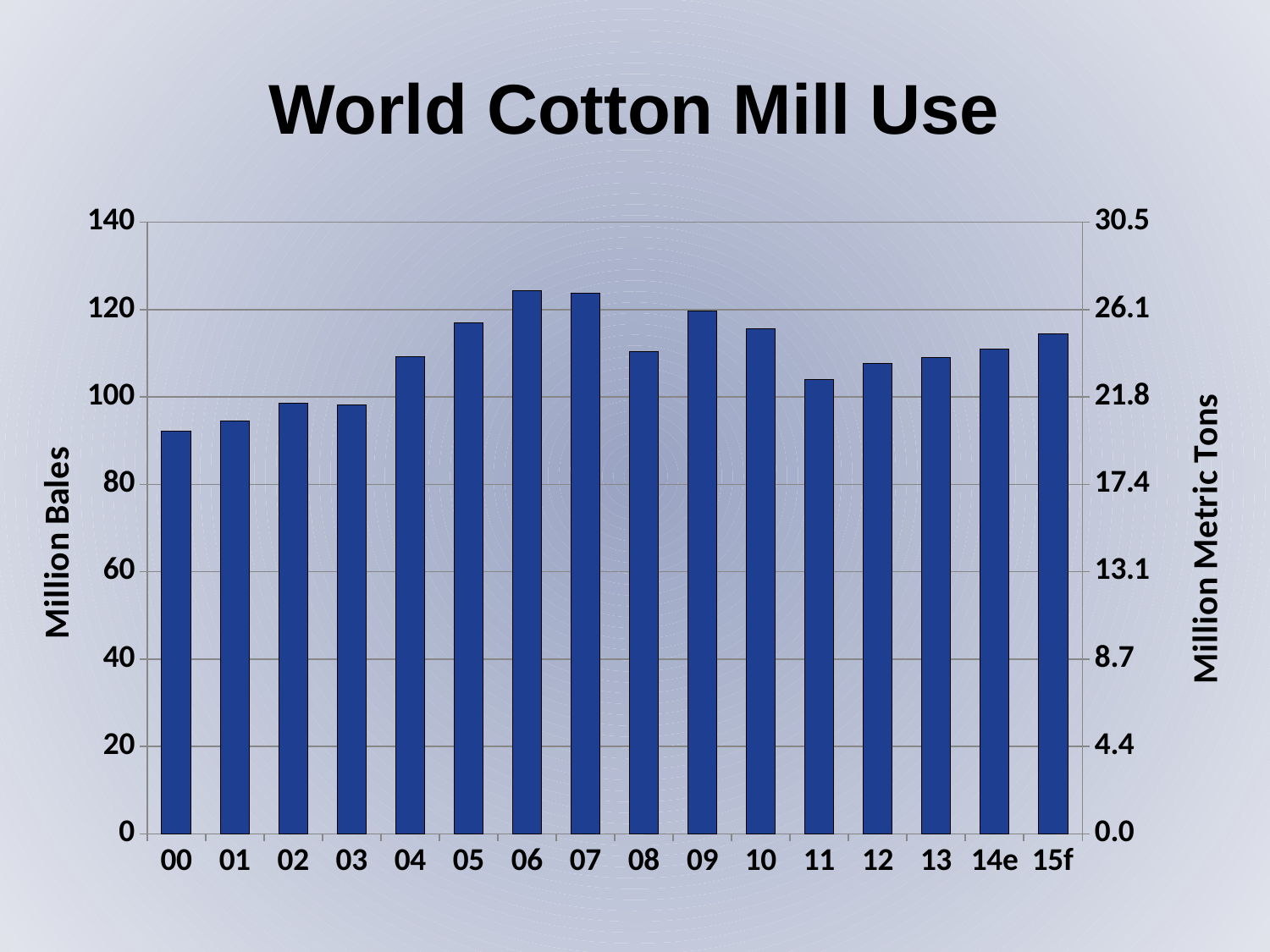
Is the value for 00 greater or less than 100 million bales? less What is the label of the left vertical axis? Million Bales What type of chart is shown on the slide? bar chart Is the value for 11 greater or less than 100 million bales? greater Is the value for 06 greater or less than 120 million bales? greater Which year has the lowest cotton mill use? 00 How many bars (years) are plotted in the chart? 16 Which is larger, the value for 10 or the value for 11? 10 Do the values generally rise or fall from 00 to 06? rise Which is larger, the value for 04 or the value for 05? 05 What is the title of the chart? World Cotton Mill Use